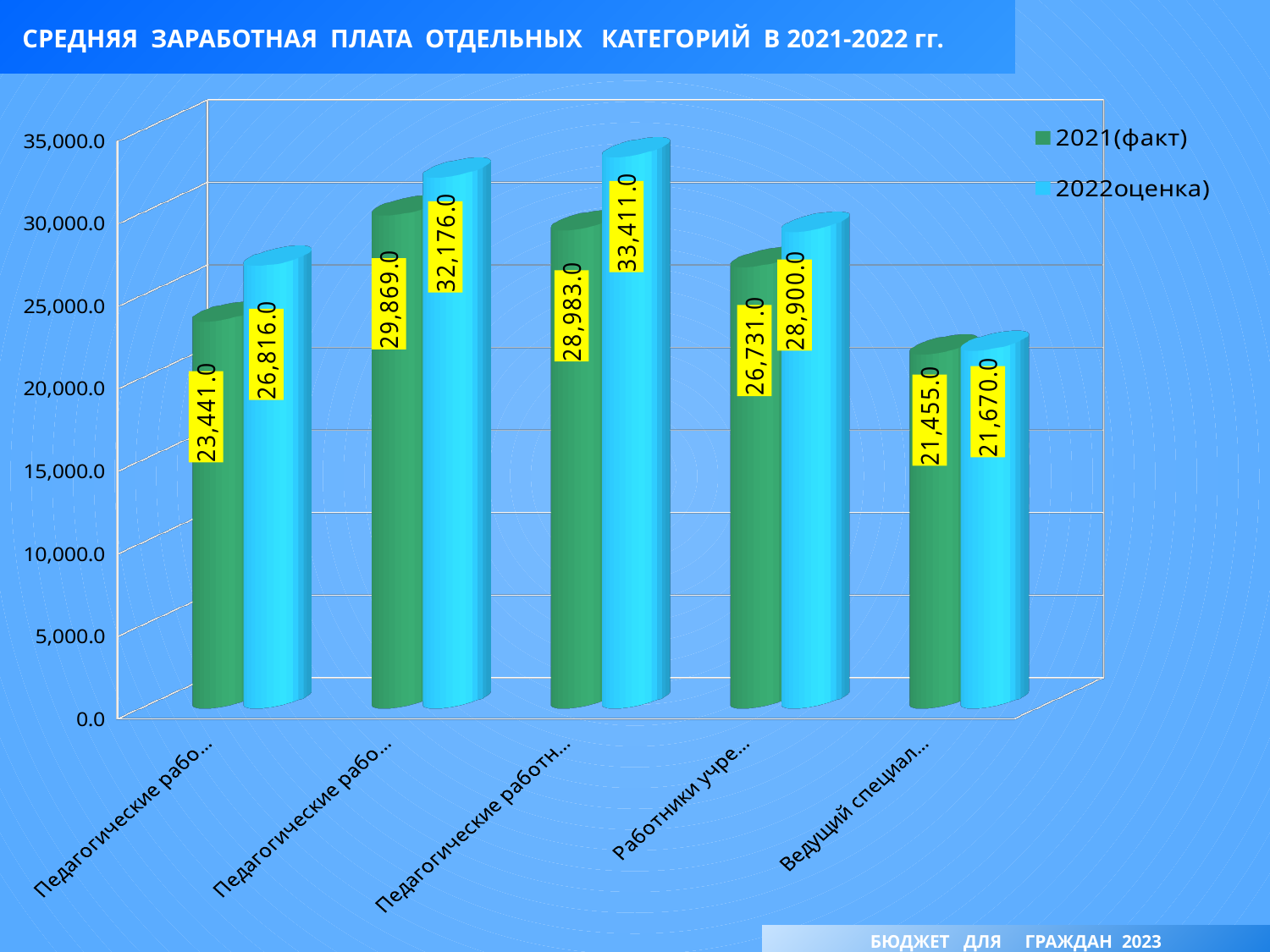
What is the 2022оценка) value for the fourth category from the left (Работники учре...)? 28,900.0 What kind of chart is shown on the slide? Bar chart For the second category from the left, what is the difference between the 2022оценка) value and the 2021(факт) value? 2,307.0 What is the 2021(факт) value for the first category from the left? 23,441.0 How many series does the legend list? 2 For the fifth category from the left (Ведущий специал...), how much higher is the 2022оценка) value than the 2021(факт) value? 215.0 Is the 2022оценка) value for the first category from the left greater or less than 25,000.0? greater What is the lowest value shown for the 2021(факт) series? 21,455.0 What is the 2021(факт) value for the fifth category from the left (Ведущий специал...)? 21,455.0 How many categories are shown on the x axis of the chart? 5 In the 2021(факт) series, which is larger: the second category from the left or the third category from the left? The second category (29,869.0) What is the highest value shown for the 2022оценка) series? 33,411.0